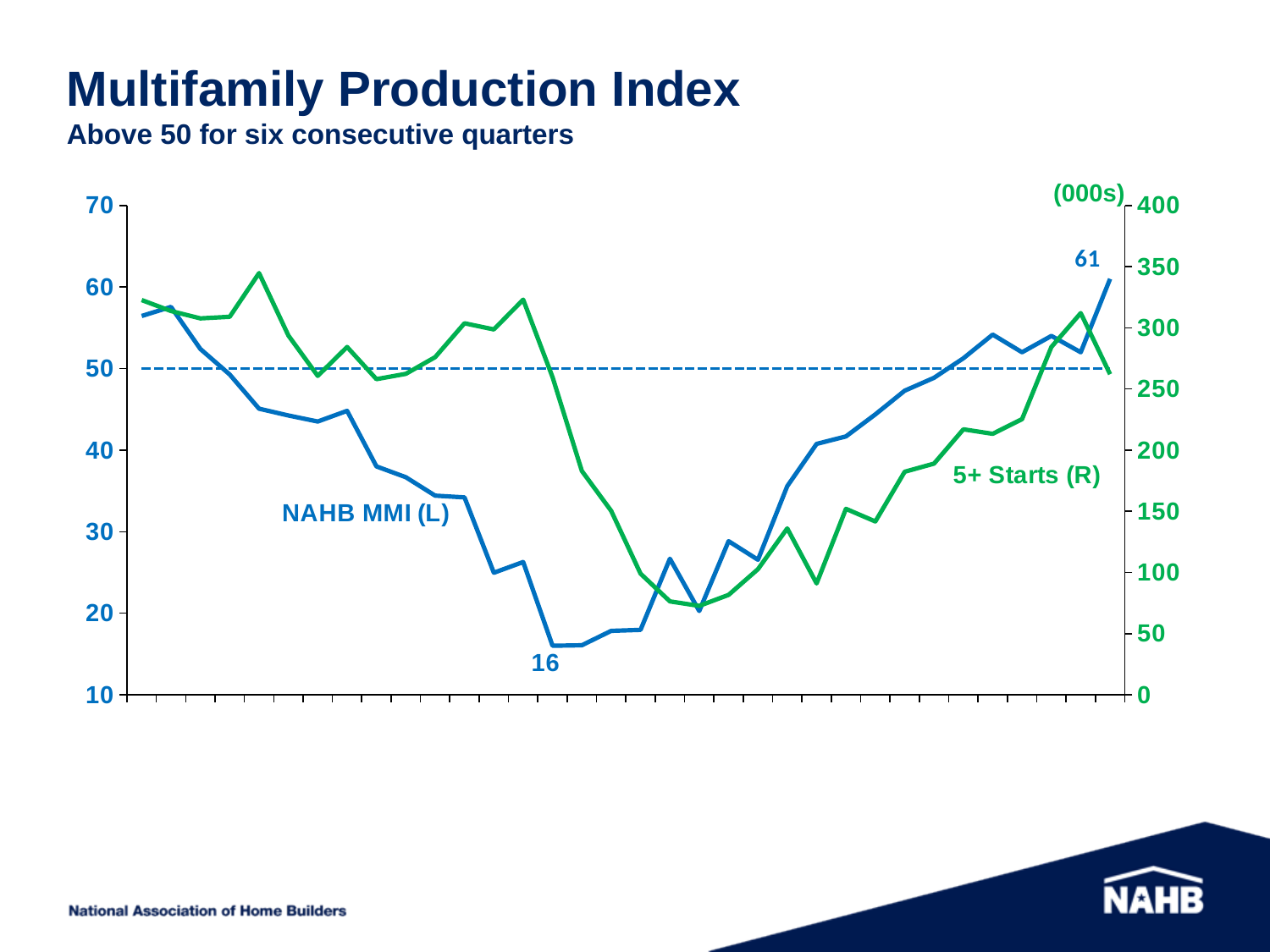
Is the most recent value of the 5+ Starts (R) series greater or less than 300? less Is the lowest point of the 5+ Starts (R) series greater or less than 100? less What is the difference between the latest NAHB MMI value (61) and its lowest labeled value (16)? 45 What type of chart is shown on the slide? line chart What is the title of the chart on the slide? Multifamily Production Index How many data series are plotted on the chart? 3 What is the most recent labeled value of the NAHB MMI (L) series? 61 At what level on the left axis is the horizontal dashed line drawn? 50 Does the NAHB MMI (L) series rise or fall over the right-hand portion of the chart? rise What is the lowest labeled value of the NAHB MMI (L) series? 16 Which of the two labeled NAHB MMI values is larger, the latest value or the trough value? the latest value (61) Is the peak value of the 5+ Starts (R) series near the left of the chart greater or less than 300? greater